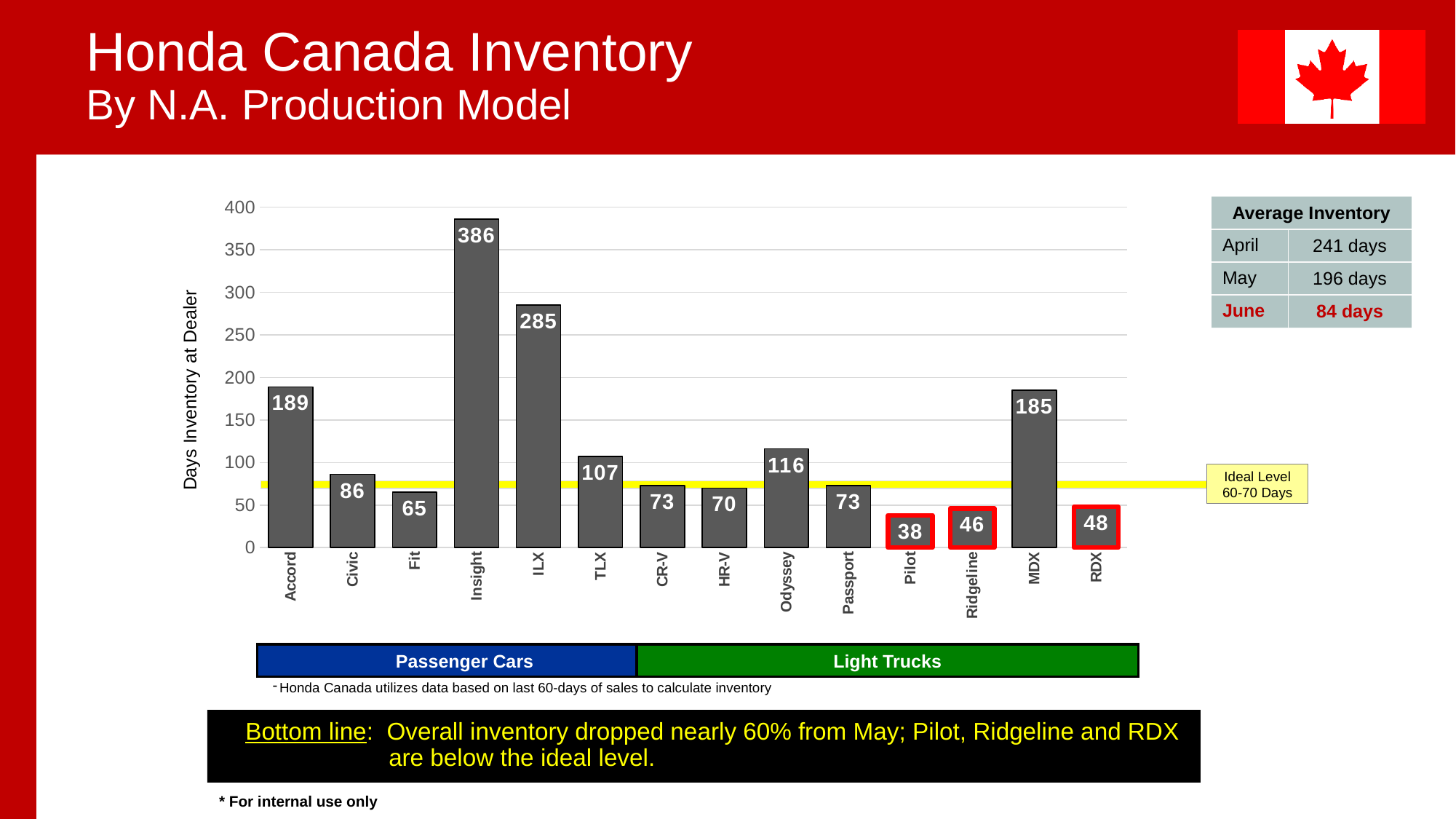
What is the label on the y axis of the chart? Days Inventory at Dealer What is the days inventory at dealer for the Ridgeline? 46 What kind of chart is used to show days inventory by model? bar chart What is the days inventory at dealer for the Insight? 386 What is the days inventory at dealer for the MDX? 185 Is the value for the Odyssey greater or less than 100? greater Which has more days inventory at dealer, the Accord or the MDX? Accord What is the difference in days inventory between the Insight and the ILX? 101 How many models are shown on the x axis of the chart? 14 Which model has the highest days inventory at dealer? Insight Which model has the lowest days inventory at dealer? Pilot What ideal level range is marked by the yellow line on the chart? 60-70 Days